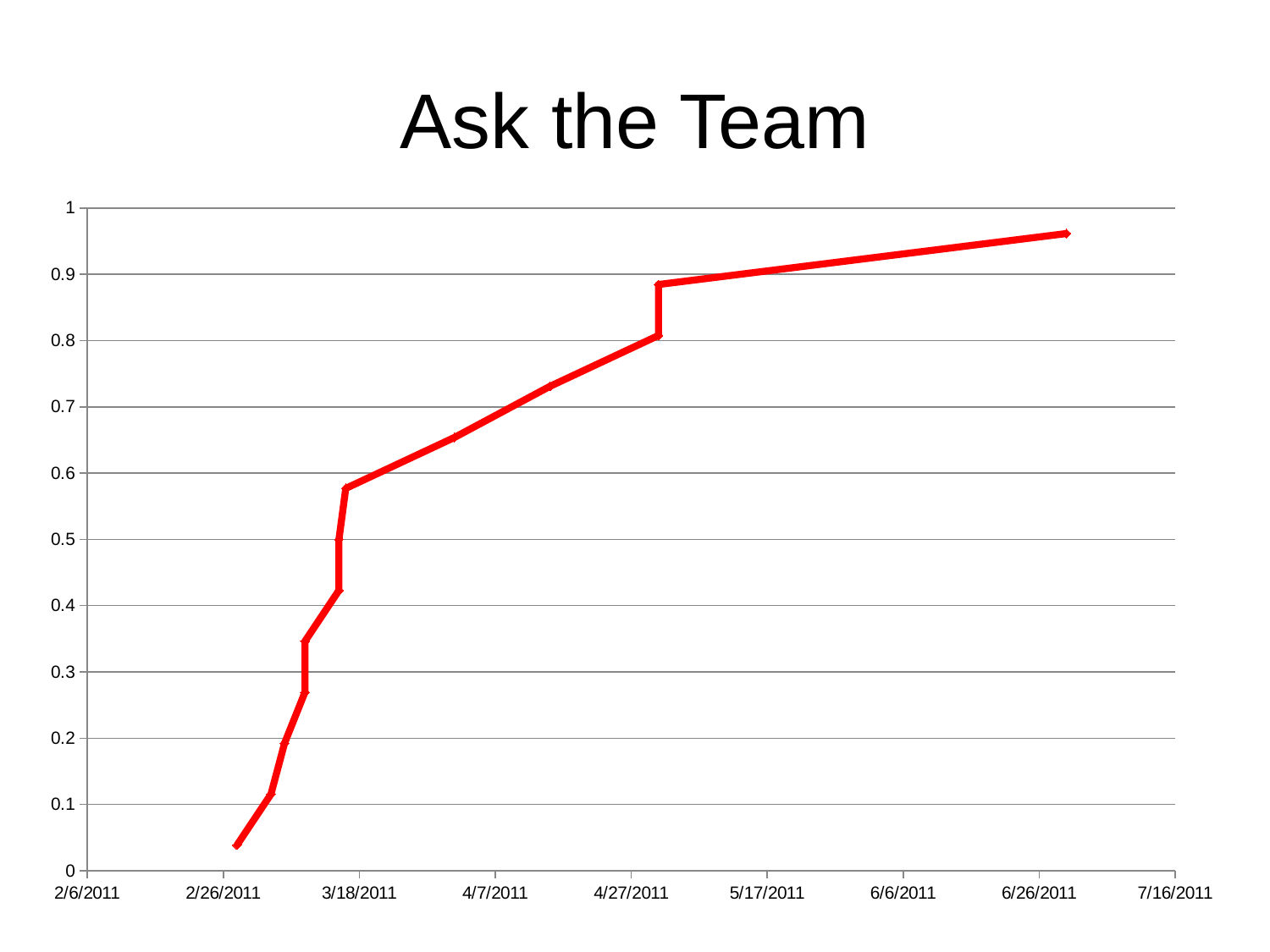
Is the value of the last (rightmost) point greater or less than 0.9? greater Which is larger, the value at the rightmost point or the value at the leftmost point? the rightmost point Is the value of the point plotted near 4/7/2011 greater or less than 0.6? greater Do the values rise or fall as the dates move from left to right along the x axis? rise What is the title of the chart? Ask the Team Is the highest value on the line greater or less than 0.9? greater What kind of chart is shown on the slide? line chart What colour is the plotted line? red How many lines (series) are plotted on the chart? 1